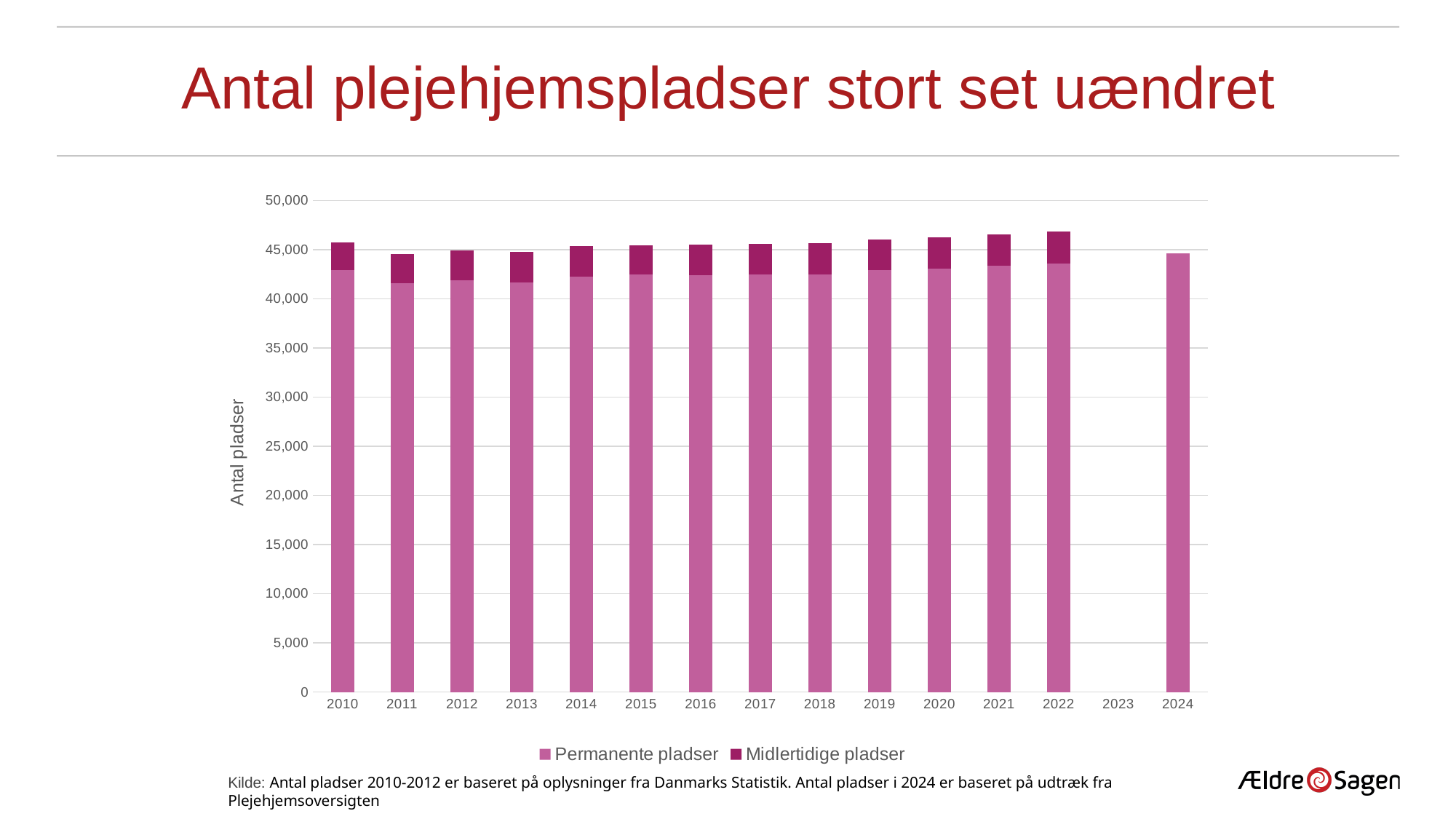
Is the value for Midlertidige pladser in 2022 greater or less than 5,000? less Is the value for Permanente pladser in 2010 greater or less than 40,000? greater Is the total number of pladser for 2024 greater or less than 40,000? greater What are the two series named in the legend? Permanente pladser and Midlertidige pladser How many years are labelled on the x axis? 15 What is the label on the y axis? Antal pladser Which year on the x axis has no bar plotted? 2023 How many series does the legend list? 2 What kind of chart is shown on the slide? Stacked bar chart